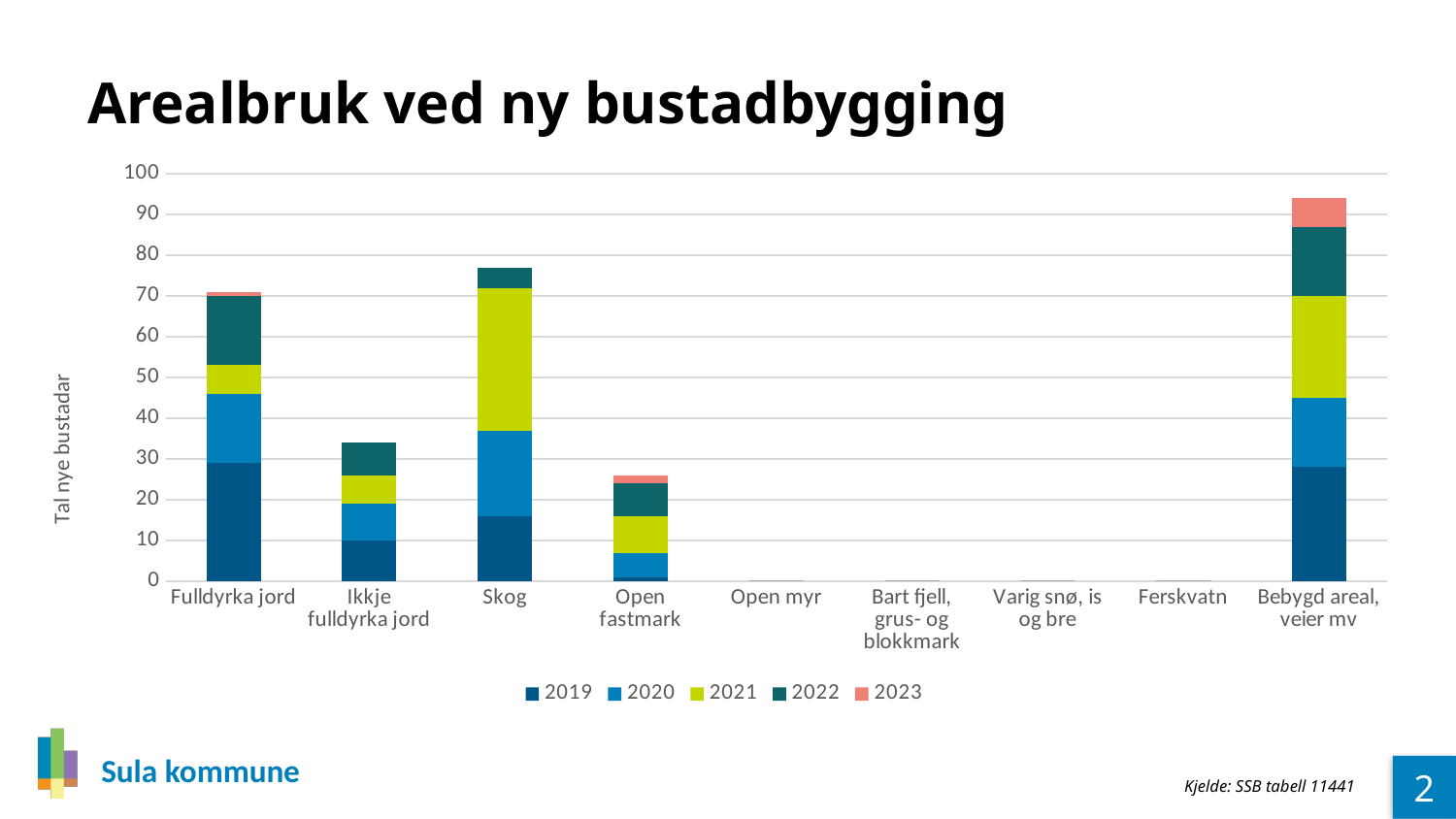
Which has the taller total bar, Ikkje fulldyrka jord or Open fastmark? Ikkje fulldyrka jord What is the label on the y axis of the chart? Tal nye bustadar What is the title of the chart? Arealbruk ved ny bustadbygging Is the total value for Skog greater or less than 70? greater Which category has the highest total stacked bar? Bebygd areal, veier mv Is the total value for Ikkje fulldyrka jord greater or less than 40? less How many series does the legend list? 5 How many categories are shown on the x axis of the chart? 9 Is the total value for Open fastmark greater or less than 30? less Which has the taller total bar, Skog or Fulldyrka jord? Skog What kind of chart is shown on the slide? stacked bar chart